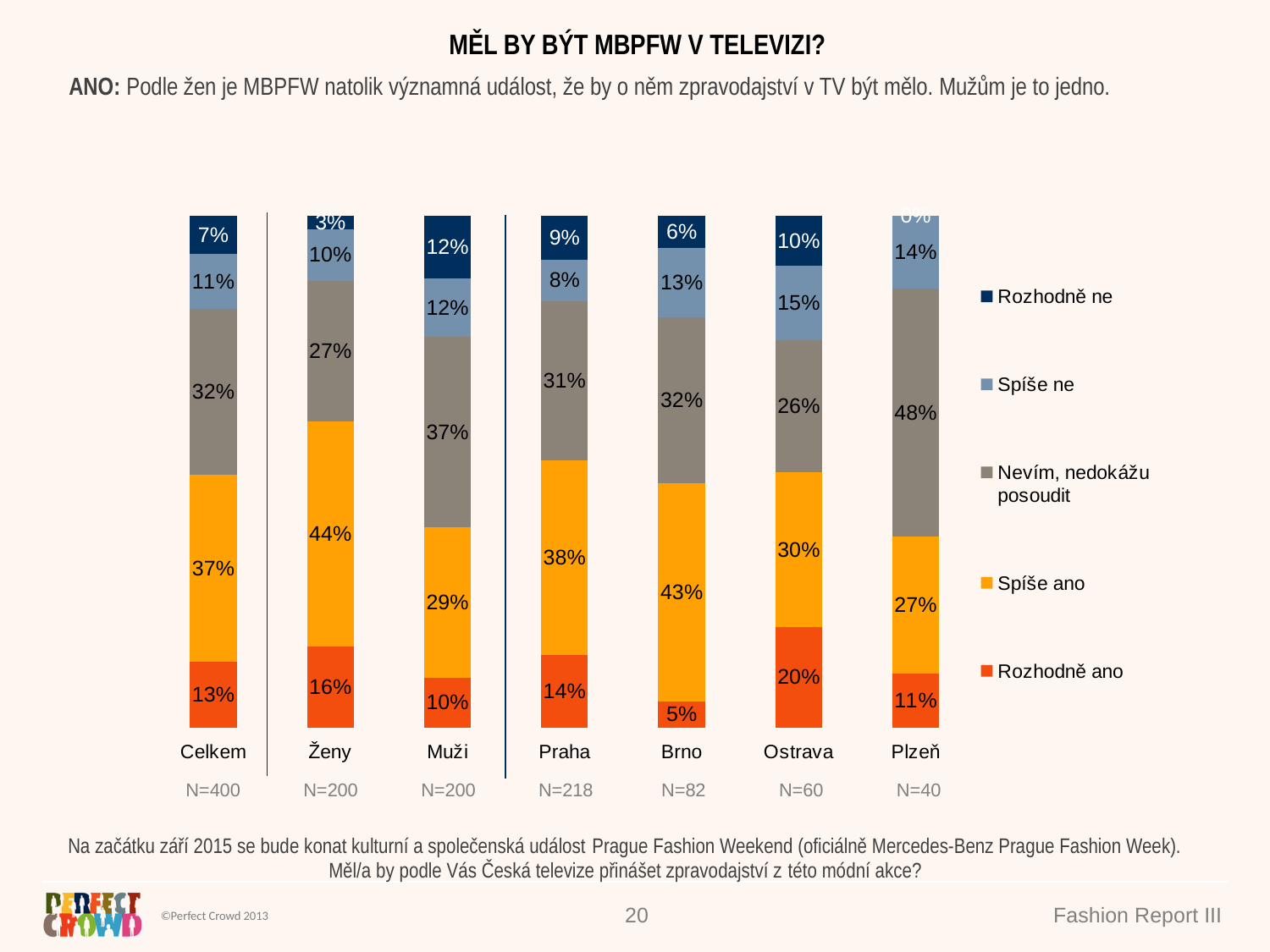
What percentage of Ženy answered "Spíše ano"? 44% Which category has the highest "Nevím, nedokážu posoudit" share? Plzeň What kind of chart is shown on the slide? Stacked bar chart How many categories are shown on the x axis? 7 What is the sample size (N) shown for Ostrava? N=60 Which is larger: the "Rozhodně ne" value for Praha or for Brno? Praha What is the difference between the "Spíše ano" values for Ženy and Muži? 15% How many series does the legend list? 5 What is the "Nevím, nedokážu posoudit" value for Plzeň? 48% What is the "Rozhodně ne" value for Muži? 12% Which category has the lowest "Rozhodně ano" share? Brno What is the "Rozhodně ano" value for Ostrava? 20%